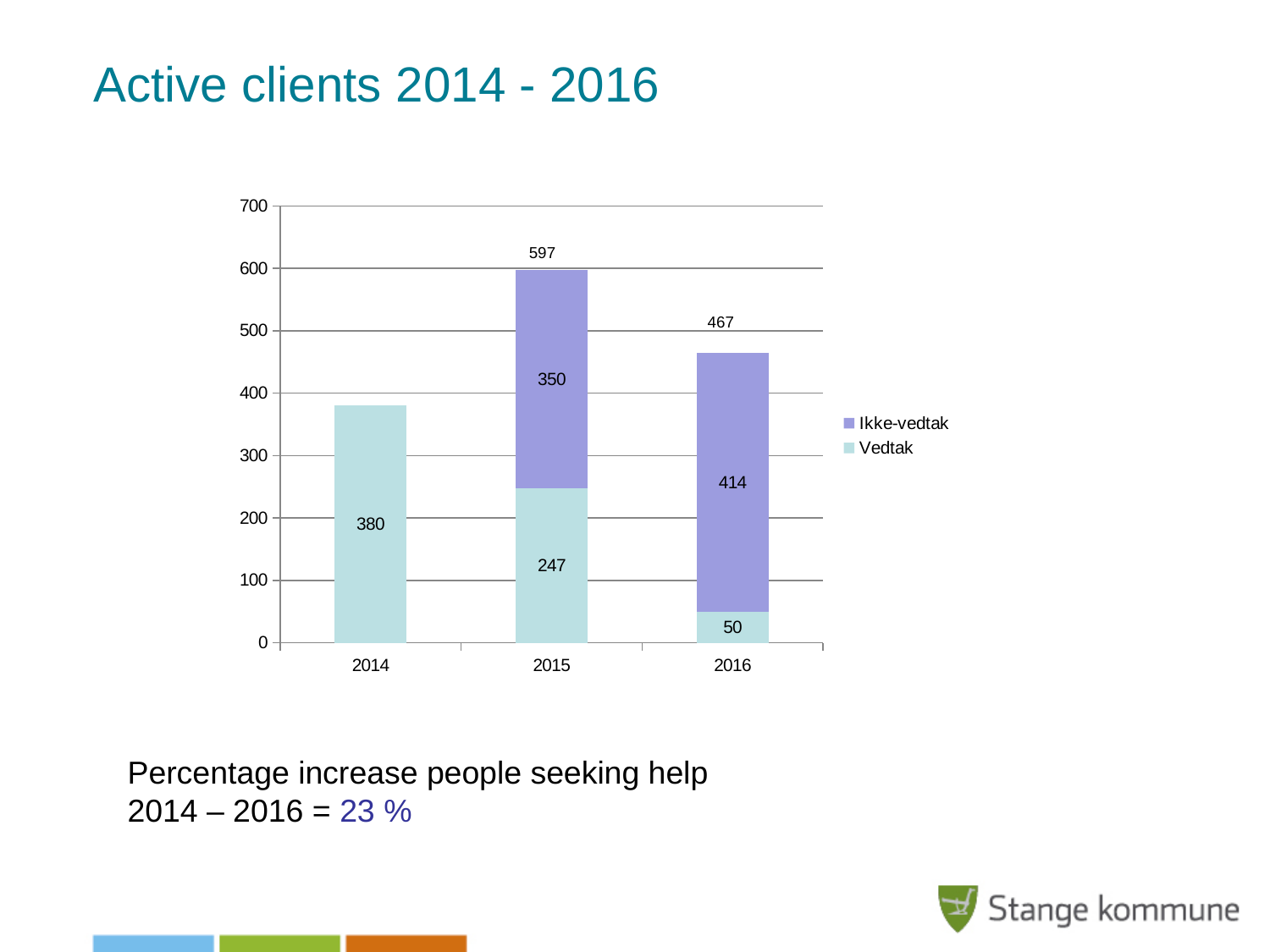
What is the Vedtak value for 2014? 380 Which is larger, the Ikke-vedtak value for 2015 or for 2016? 2016 Which year has the lowest Vedtak value? 2016 What is the Vedtak value for 2015? 247 What is the Ikke-vedtak value for 2015? 350 What is the difference between the Vedtak values for 2014 and 2015? 133 What kind of chart is shown on the slide? stacked bar chart What is the Ikke-vedtak value for 2016? 414 What total is printed above the 2015 bar? 597 What total is printed above the 2016 bar? 467 How many years are shown on the x axis? 3 How many series does the legend list? 2